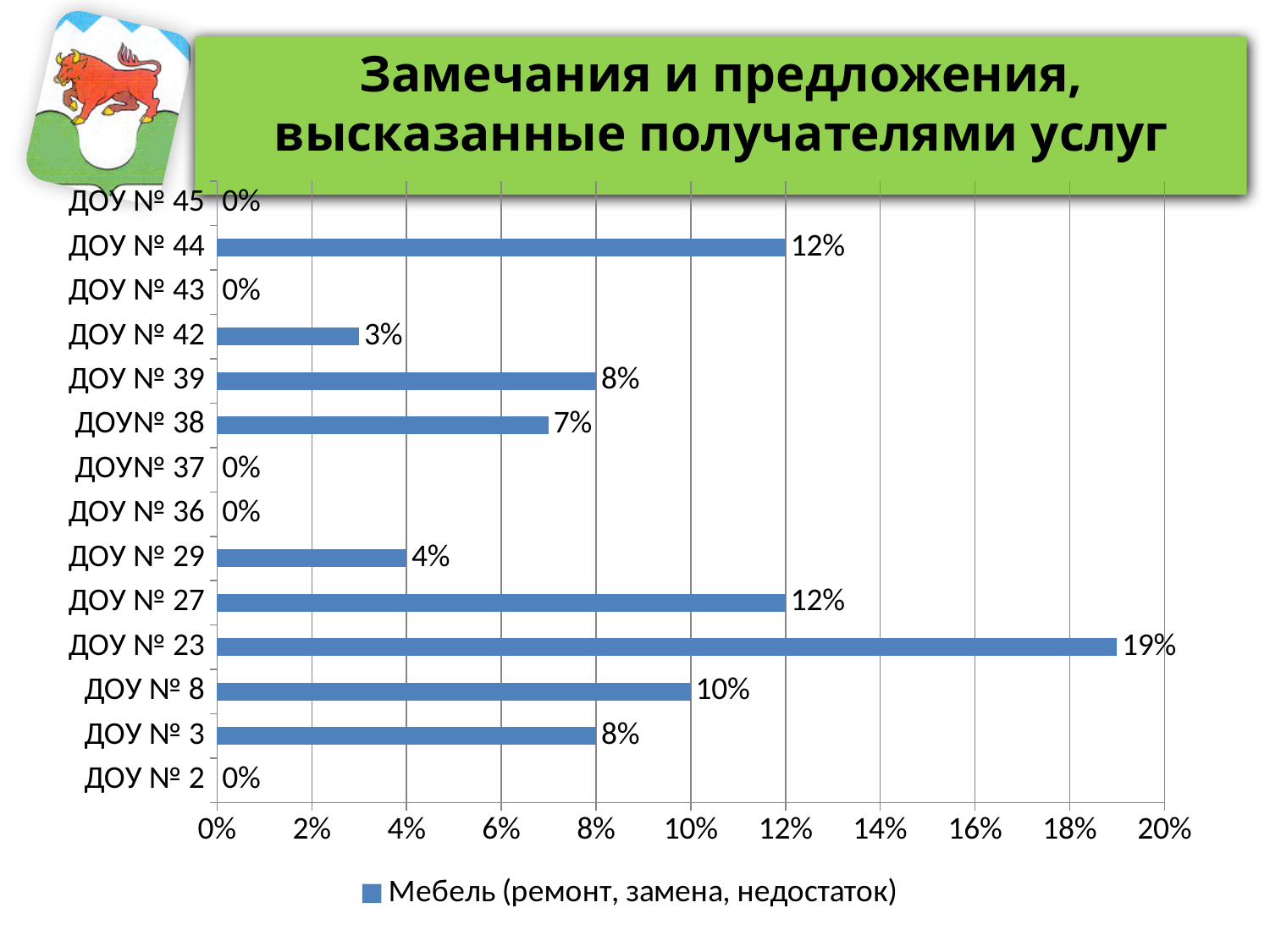
What is the value for ДОУ № 8? 10% How many series does the legend list? 1 What is the legend entry of the chart? Мебель (ремонт, замена, недостаток) What is the value for ДОУ № 42? 3% What is the value for ДОУ№ 38? 7% Which is larger, the value for ДОУ № 39 or the value for ДОУ № 29? ДОУ № 39 How many categories have a value of 0%? 5 Which category has the highest value? ДОУ № 23 How many categories are shown on the chart? 14 What kind of chart is shown on the slide? Bar chart What is the difference between the values for ДОУ № 23 and ДОУ № 44? 7% What is the value for ДОУ № 23? 19%